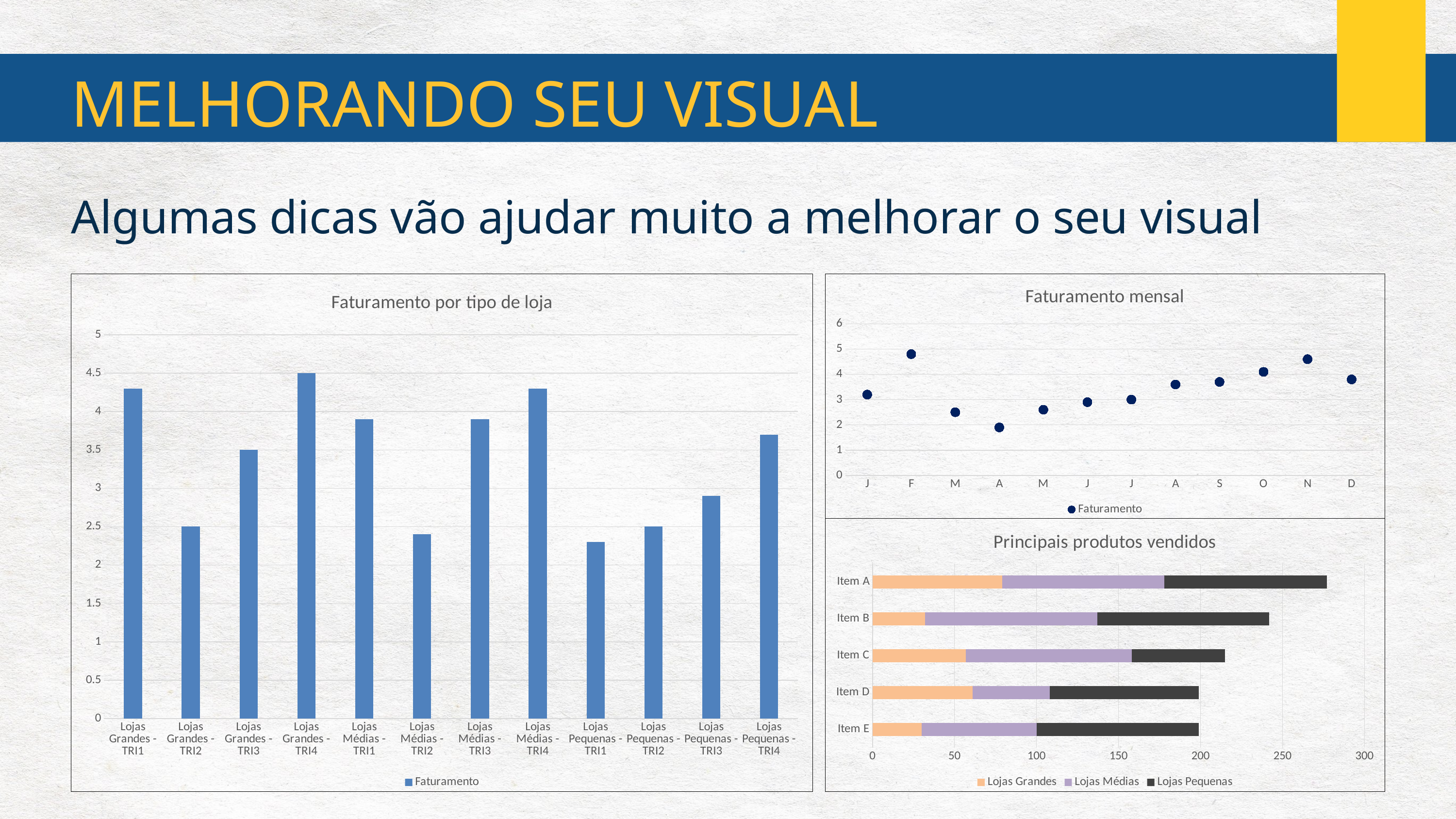
In the chart titled "Principais produtos vendidos", which item has the longest total bar? Item A In the chart titled "Principais produtos vendidos", is the total for Item A greater or less than 250? greater In the chart titled "Faturamento mensal", do the values rise or fall from J (July) to N? rise In the chart titled "Faturamento por tipo de loja", which category has the highest bar? Lojas Grandes - TRI4 How many categories are shown in the chart titled "Faturamento por tipo de loja"? 12 How many series does the legend of the chart titled "Principais produtos vendidos" list? 3 In the chart titled "Faturamento por tipo de loja", is the value for Lojas Grandes - TRI2 greater or less than 3? less In the chart titled "Faturamento por tipo de loja", which is larger: Lojas Grandes - TRI3 or Lojas Médias - TRI3? Lojas Médias - TRI3 In the chart titled "Faturamento mensal", which month has the lowest value? A What kind of chart is "Faturamento por tipo de loja"? Bar chart In the chart titled "Faturamento por tipo de loja", is the value for Lojas Grandes - TRI1 greater or less than 4? greater